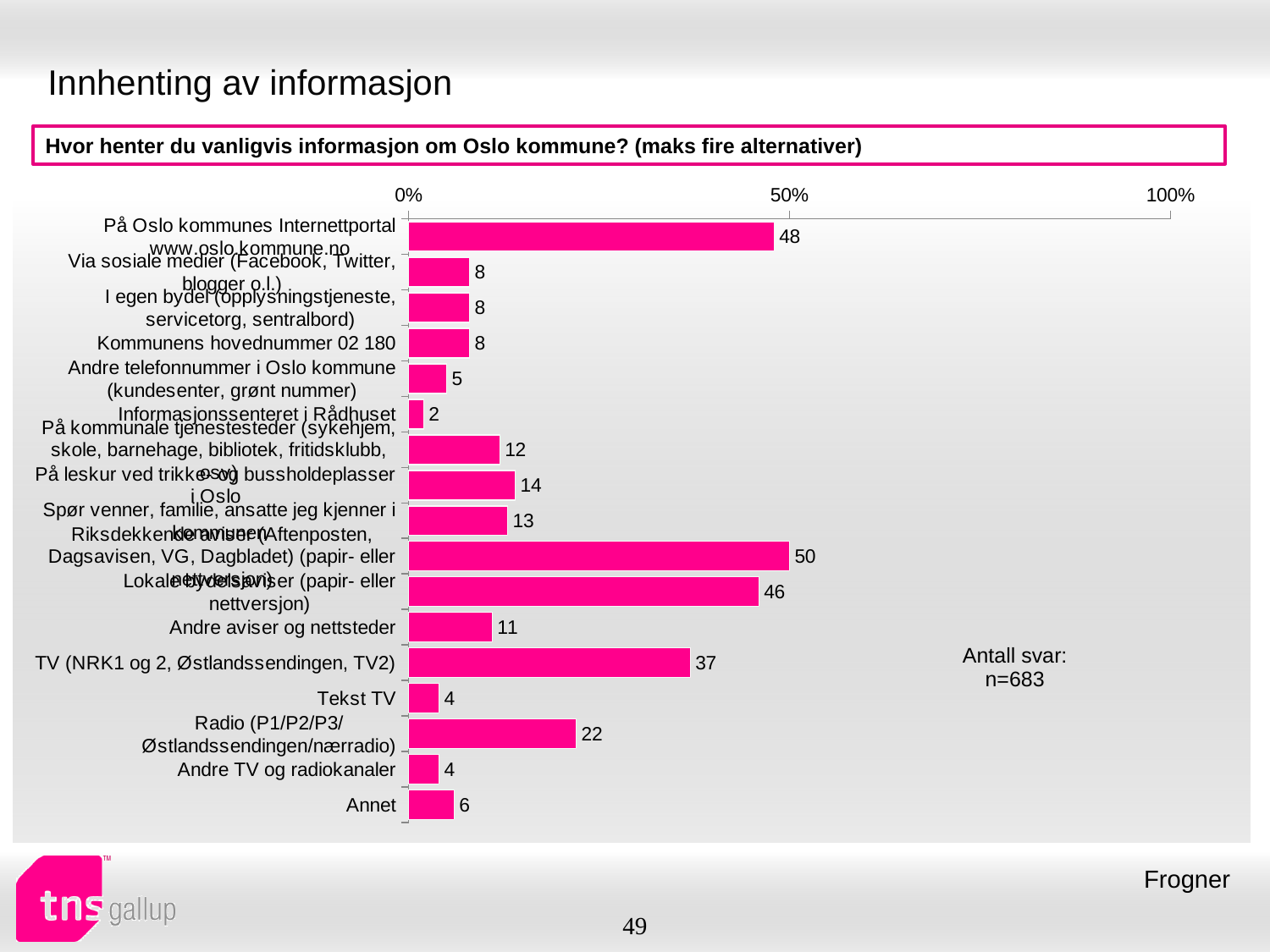
Which is larger: the value for "Radio (P1/P2/P3/Østlandssendingen/nærradio)" or the value for "Andre aviser og nettsteder"? Radio (P1/P2/P3/Østlandssendingen/nærradio) What value is shown for "Annet"? 6 Is the value for "På Oslo kommunes Internettportal www.oslo.kommune.no" greater or less than 50%? less What kind of chart is shown on the slide? Bar chart How many categories are shown in the chart? 17 What is the number of respondents (n) stated on the slide? n=683 What value is shown for "Kommunens hovednummer 02 180"? 8 What value is shown for "Tekst TV"? 4 What is the difference between the values for "Riksdekkende aviser" and "Lokale bydelsaviser"? 4 Which category has the highest value? Riksdekkende aviser (Aftenposten, Dagsavisen, VG, Dagbladet) (papir- eller nettversjon) Which category has the lowest value? Informasjonssenteret i Rådhuset What value is shown for "TV (NRK1 og 2, Østlandssendingen, TV2)"? 37